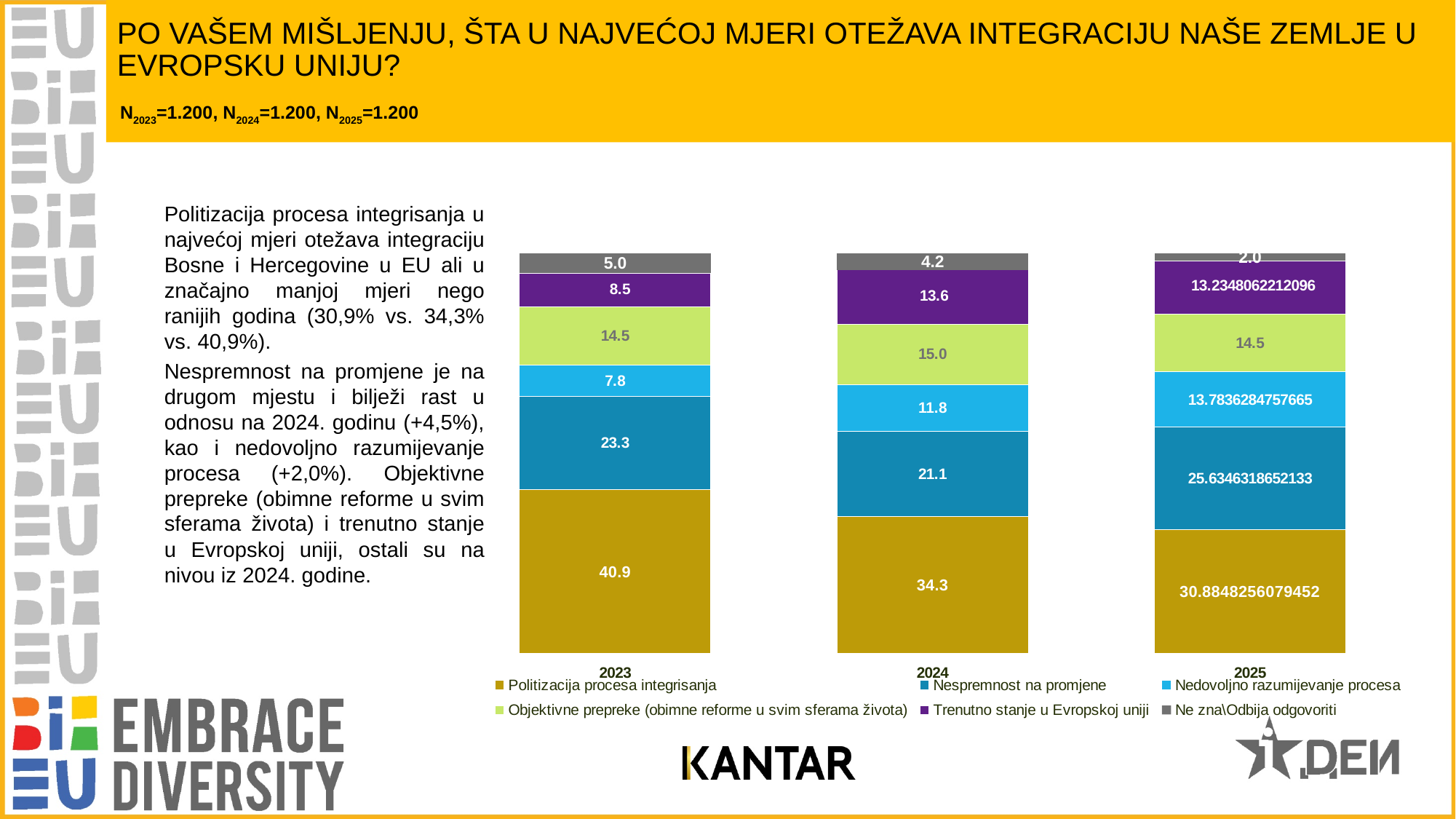
How many years (categories) are shown on the x axis? 3 In which year is the value for Ne zna\Odbija odgovoriti the lowest? 2025 What kind of chart is shown on the slide? Stacked bar chart What is the difference between the Politizacija procesa integrisanja values for 2023 and 2024? 6.6 In which year is the value for Politizacija procesa integrisanja the highest? 2023 What is the value for Politizacija procesa integrisanja in 2023? 40.9 Does the value for Politizacija procesa integrisanja rise or fall from 2023 to 2025? Fall What is the value for Ne zna\Odbija odgovoriti in 2023? 5.0 What is the value for Objektivne prepreke (obimne reforme u svim sferama života) in 2024? 15.0 How many series does the legend list? 6 Which year has the larger value for Nedovoljno razumijevanje procesa, 2023 or 2024? 2024 What is the value for Nespremnost na promjene in 2024? 21.1